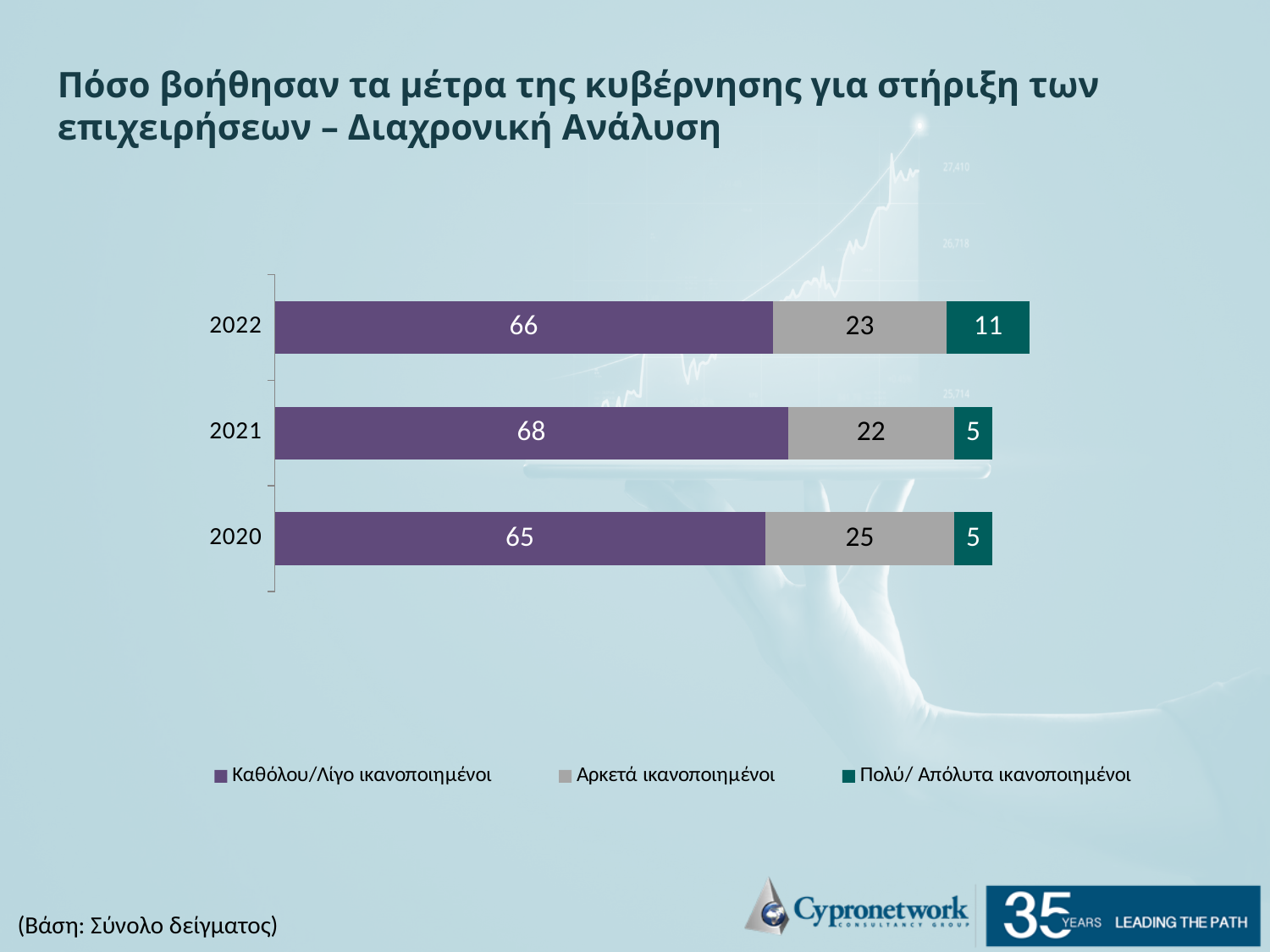
What is the value for Αρκετά ικανοποιημένοι in 2020? 25 What kind of chart is shown on the slide? Stacked bar chart Is the Αρκετά ικανοποιημένοι value larger in 2020 or in 2022? 2020 Which year has the lowest value for Αρκετά ικανοποιημένοι? 2021 What is the value for Καθόλου/Λίγο ικανοποιημένοι in 2022? 66 How many series does the legend list? 3 How many years are shown on the chart? 3 What is the difference between the Πολύ/ Απόλυτα ικανοποιημένοι values for 2022 and 2021? 6 What is the value for Πολύ/ Απόλυτα ικανοποιημένοι in 2021? 5 Which year has the highest value for Καθόλου/Λίγο ικανοποιημένοι? 2021 Which year has the highest value for Πολύ/ Απόλυτα ικανοποιημένοι? 2022 What is the total of the stacked bar for 2022? 100